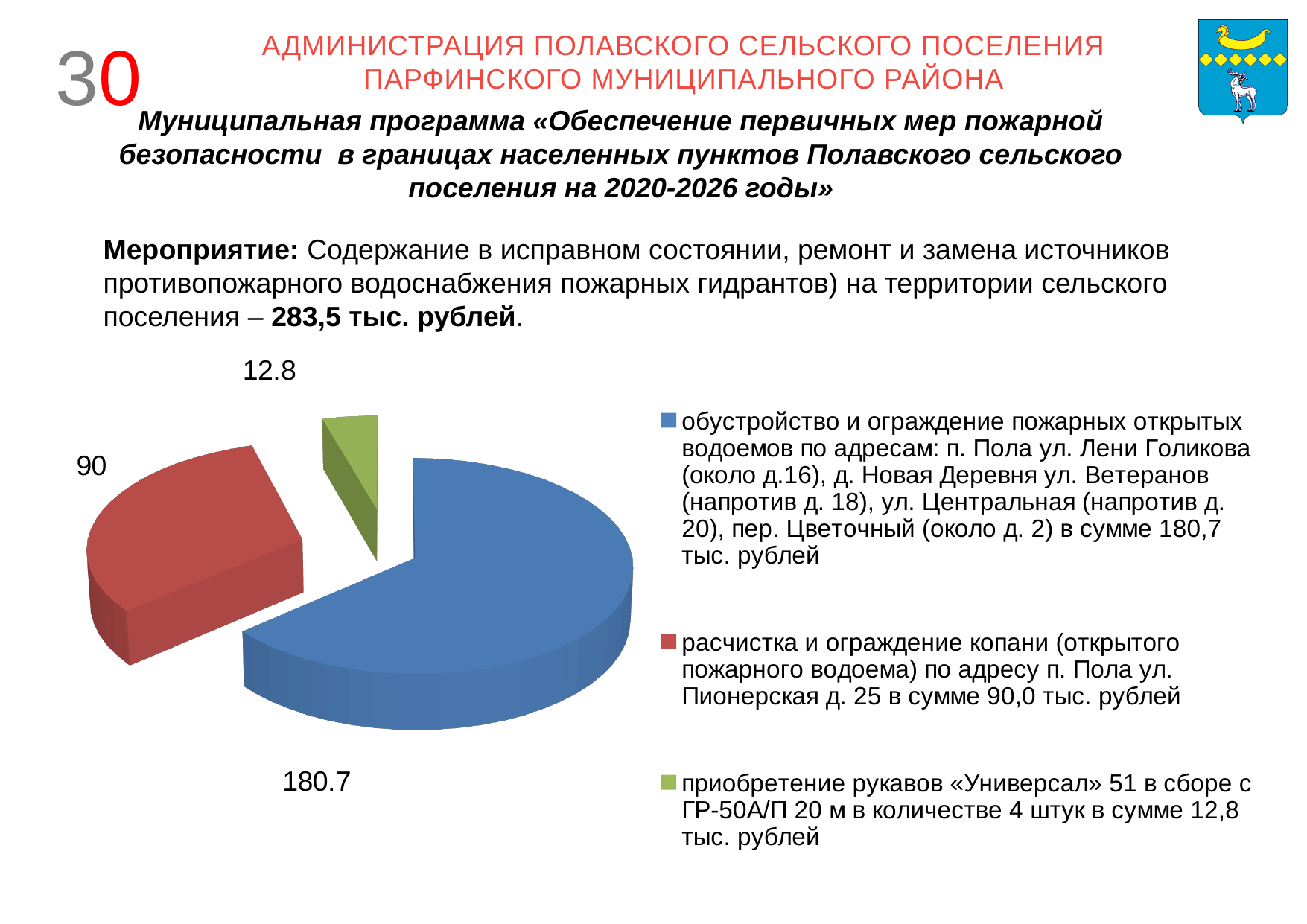
What is the total of the three values shown on the pie chart? 283.5 Which slice of the pie chart has the largest value? обустройство и ограждение пожарных открытых водоемов (180.7) What value is shown for the red slice (расчистка и ограждение копани)? 90 Which is larger: the value for расчистка и ограждение копани or the value for приобретение рукавов «Универсал»? расчистка и ограждение копани (90) How many entries does the legend of the pie chart list? 3 What is the difference between the value of the blue slice (180.7) and the red slice (90)? 90.7 How many slices does the pie chart have? 3 What value is shown for the green slice (приобретение рукавов «Универсал»)? 12.8 What kind of chart is shown on the slide? Pie chart Which slice of the pie chart has the smallest value? приобретение рукавов «Универсал» (12.8) What colour is the slice representing приобретение рукавов «Универсал»? Green What value is shown for the blue slice (обустройство и ограждение пожарных открытых водоемов)? 180.7